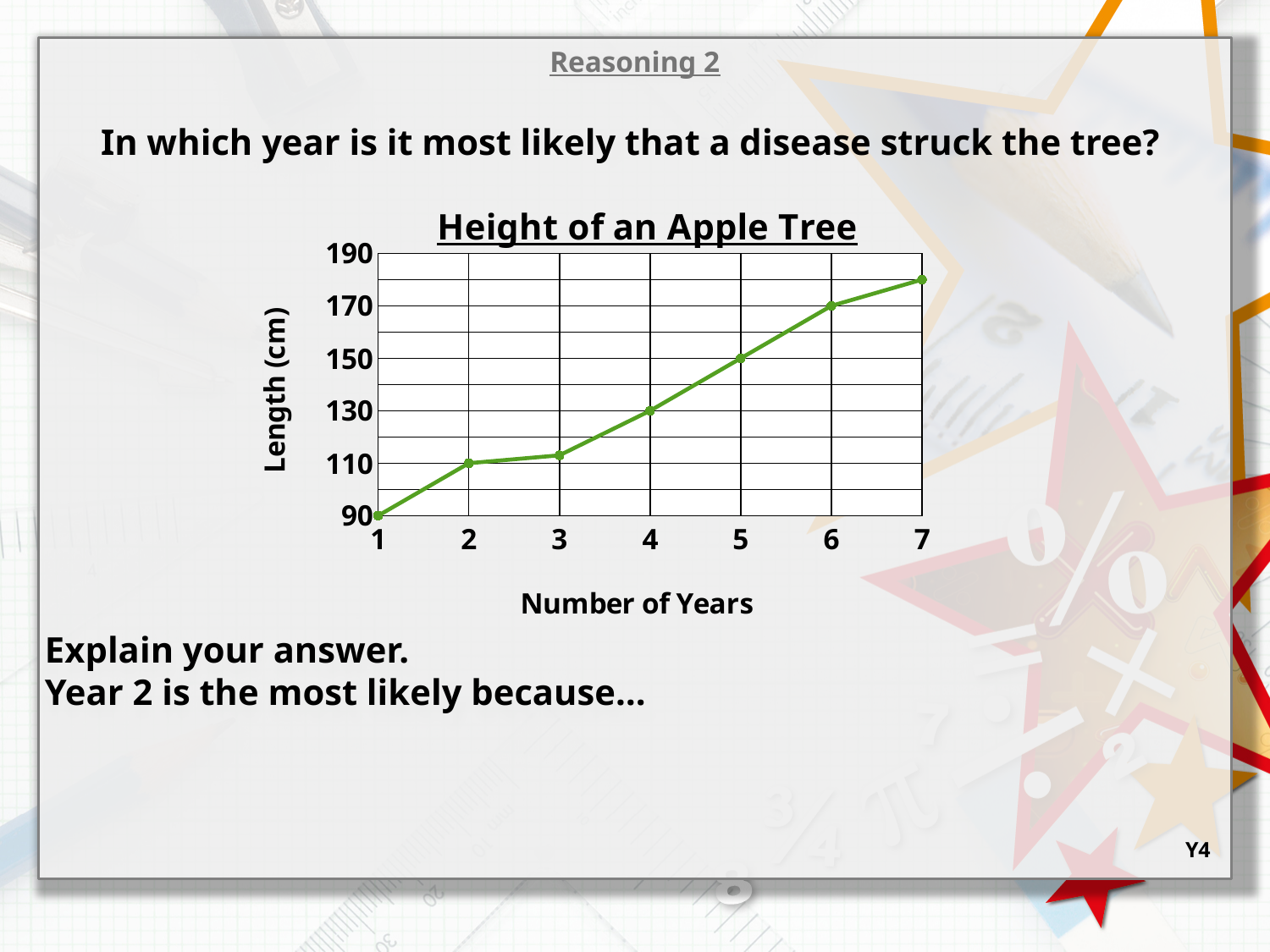
In which year is the height of the apple tree lowest? 1 What kind of chart is shown on the slide? line chart What is the height of the apple tree at year 1? 90 Is the height at year 7 greater or less than 170? greater What is the title of the chart? Height of an Apple Tree What is the height of the apple tree at year 2? 110 In which year is the height of the apple tree greatest? 7 What is the height of the apple tree at year 4? 130 How many data points are plotted on the chart? 7 Does the height of the apple tree rise or fall as the number of years increases? rise What is the height of the apple tree at year 6? 170 What is the difference in height between year 6 and year 4? 40